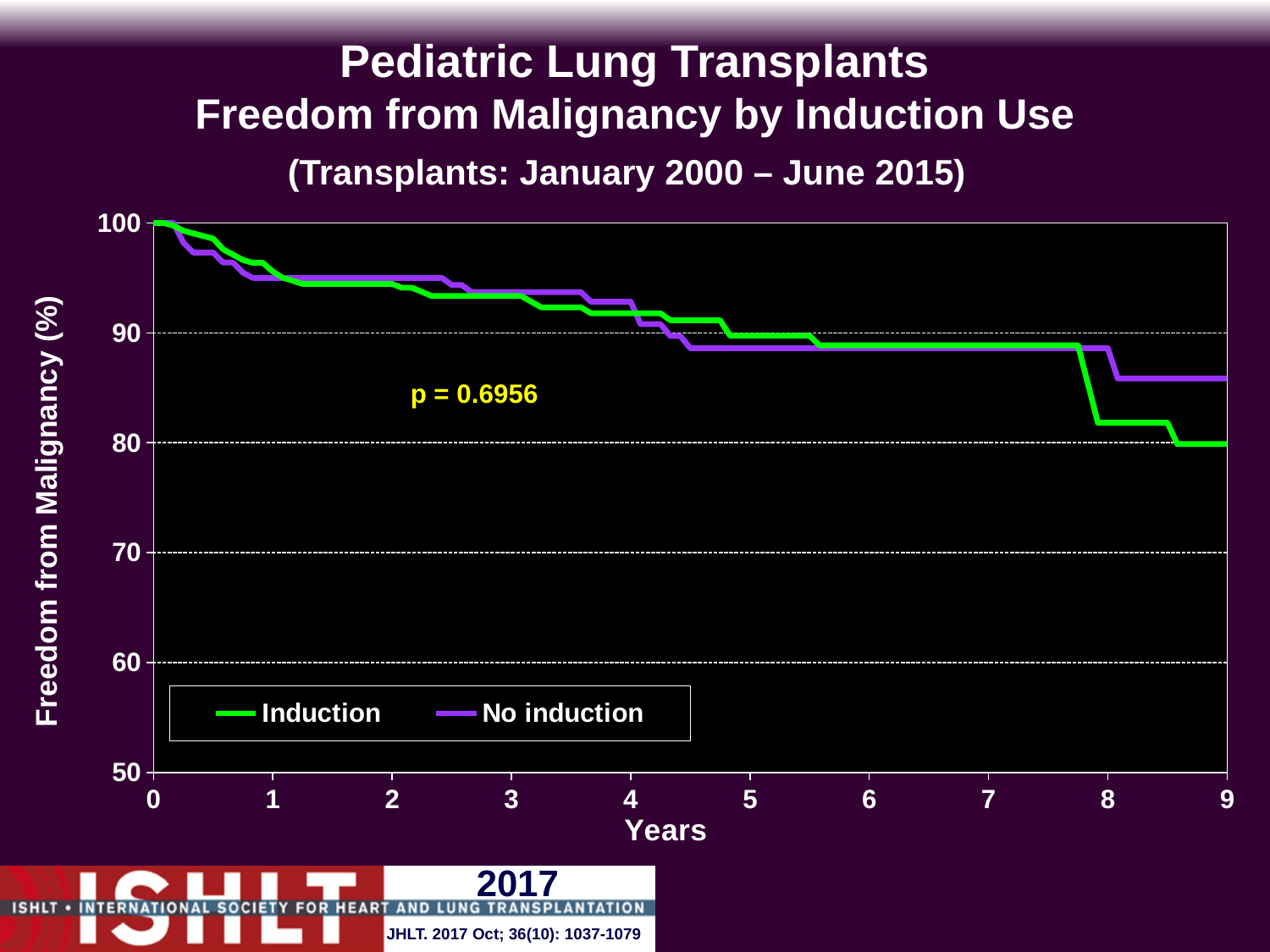
At 9 years, which series has the higher freedom from malignancy, Induction or No induction? No induction Is the value for Induction at 5 years greater or less than 80? greater What is the label of the y-axis? Freedom from Malignancy (%) How many series does the legend list? 2 What type of chart is shown on the slide? Line chart Is the value for No induction at 2 years greater or less than 90? greater What is the maximum value shown on the x-axis (Years)? 9 Is the value for Induction at 9 years greater or less than 90? less What is the p-value printed on the chart? p = 0.6956 Do the freedom from malignancy curves rise or fall as years increase? Fall What are the two series named in the legend? Induction and No induction